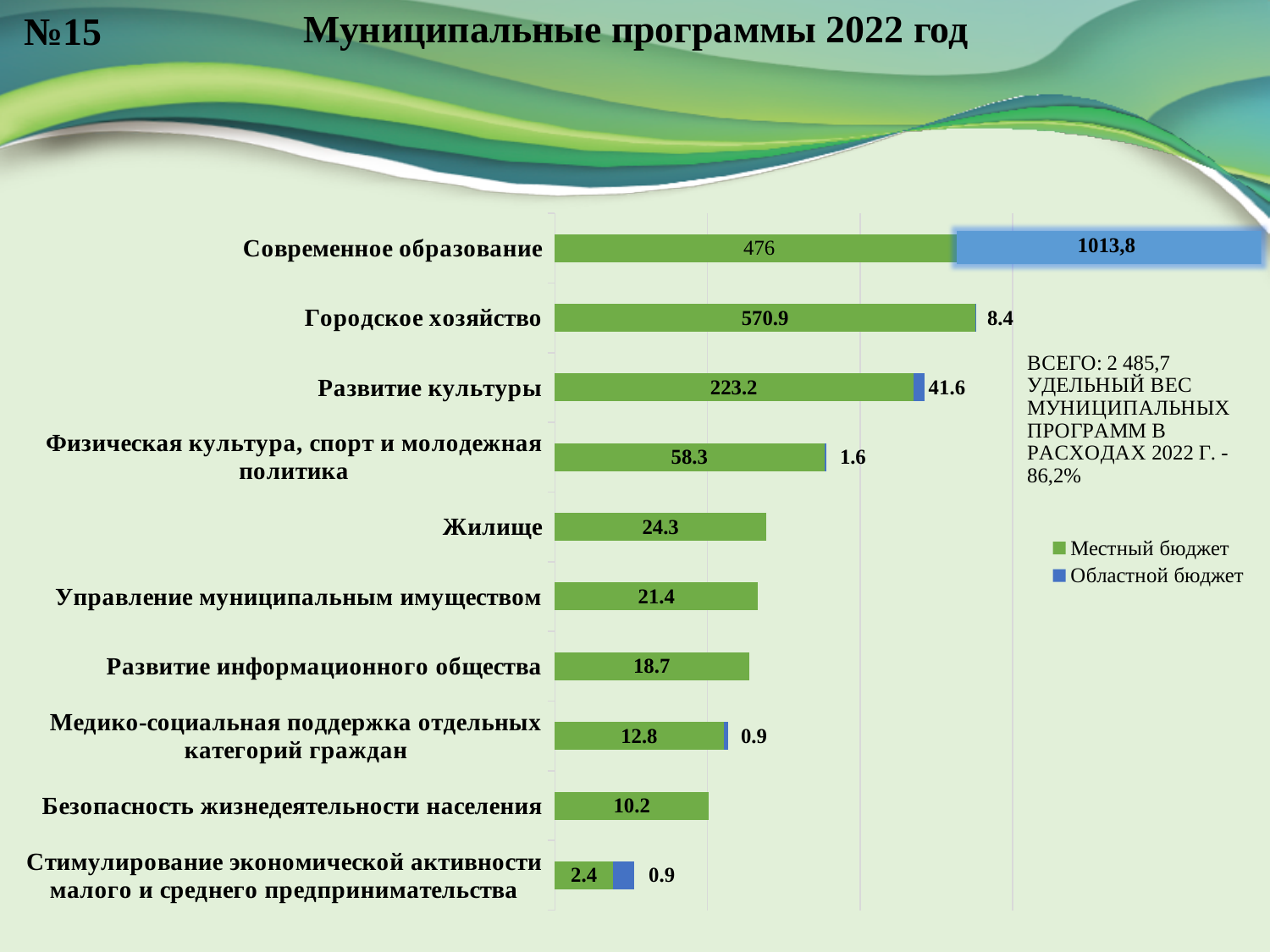
What is the total of the stacked bar for Развитие культуры (Местный бюджет plus Областной бюджет)? 264.8 How many series does the legend list? 2 Which program has the highest Местный бюджет value? Городское хозяйство What is the Областной бюджет value for Развитие культуры? 41.6 How much larger is the Местный бюджет value for Городское хозяйство than for Современное образование? 94.9 What kind of chart is shown on the slide? Bar chart Which program has the lowest Местный бюджет value? Стимулирование экономической активности малого и среднего предпринимательства Which has the larger Местный бюджет value: Развитие культуры or Физическая культура, спорт и молодежная политика? Развитие культуры How many programs (categories) are shown in the chart? 10 What is the Областной бюджет value for Современное образование? 1013,8 What is the Местный бюджет value for Жилище? 24.3 What is the Местный бюджет value for Городское хозяйство? 570.9